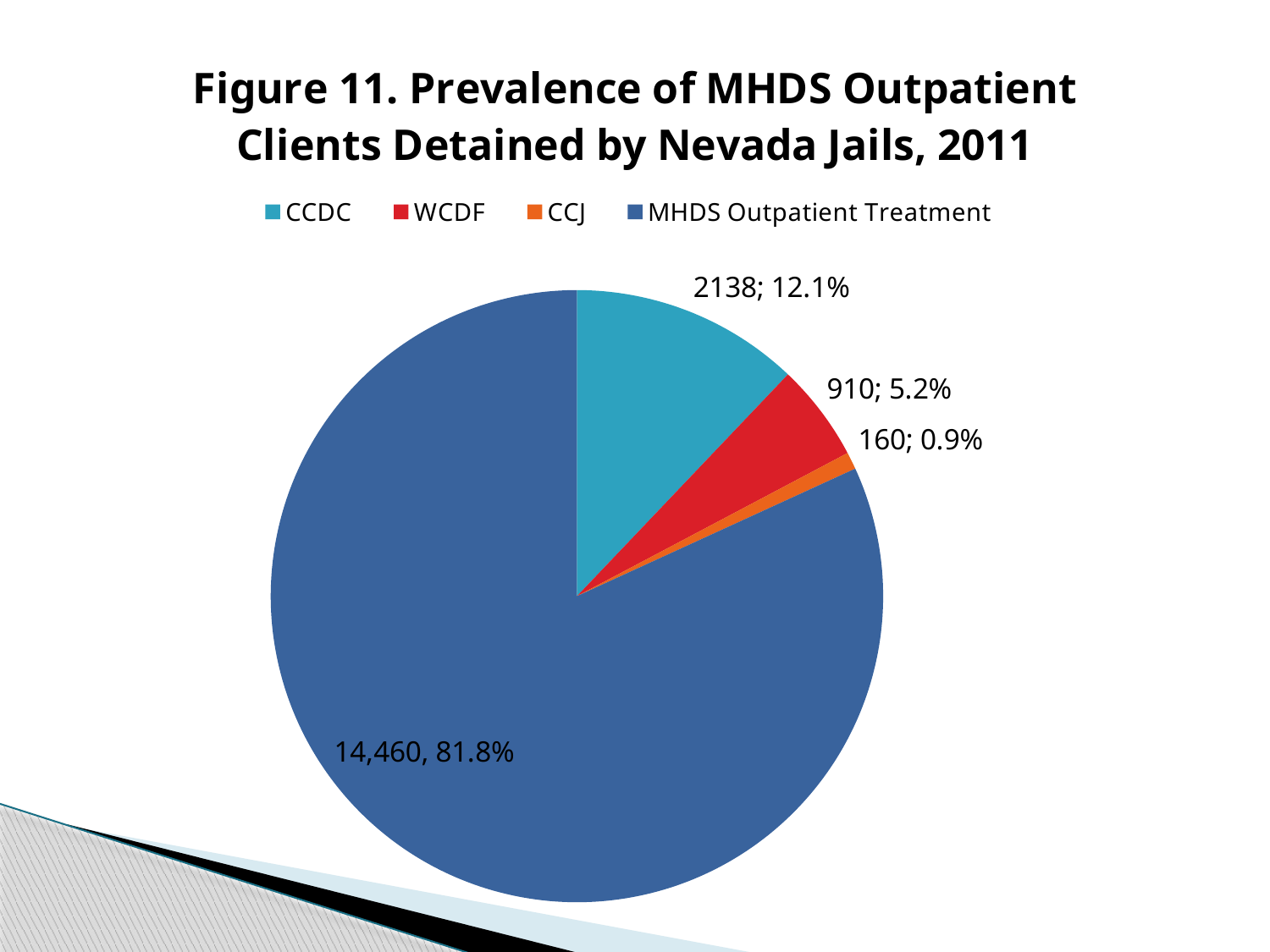
What percentage share does WCDF have? 5.2% What is the title of the chart? Figure 11. Prevalence of MHDS Outpatient Clients Detained by Nevada Jails, 2011 How many entries does the legend list? 4 What value is shown for CCJ? 160 What is the difference between the values for CCDC and WCDF? 1228 Which category has the smallest slice? CCJ How many slices does the pie chart have? 4 What percentage share does MHDS Outpatient Treatment have? 81.8% Which category has the largest slice? MHDS Outpatient Treatment What kind of chart is shown on the slide? pie chart Which is larger, the value for WCDF or the value for CCJ? WCDF What value is shown for CCDC? 2138